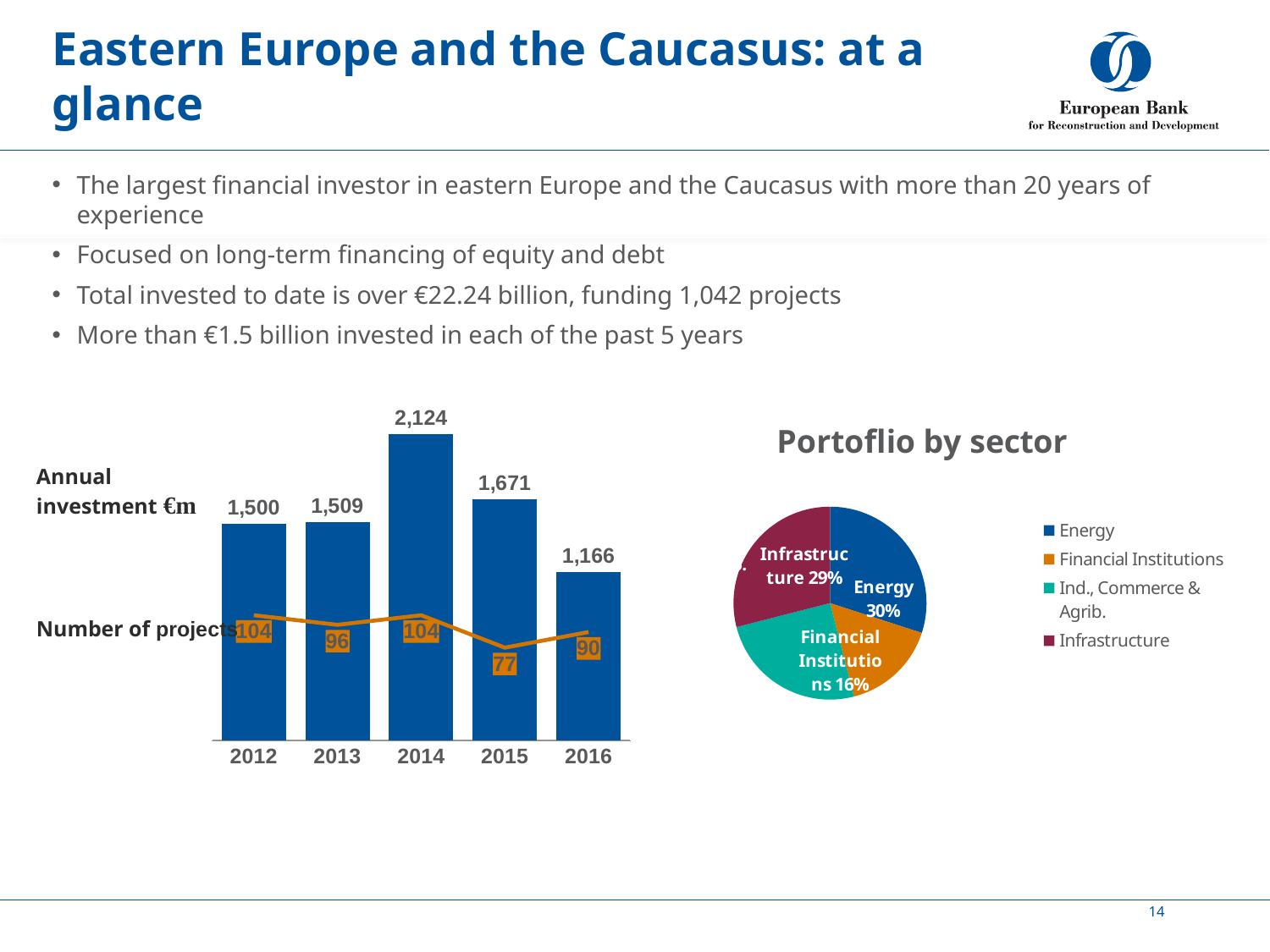
In the annual investment chart on the left, what was the annual investment in 2014? 2,124 In the annual investment chart on the left, which year had the lowest annual investment? 2016 In the 'Portoflio by sector' pie chart, how many sectors does the legend list? 4 In the annual investment chart on the left, which year had the highest annual investment? 2014 In the annual investment chart on the left, how many years are shown on the x axis? 5 In the annual investment chart on the left, which year had the fewest projects? 2015 What kind of chart is the 'Portoflio by sector' chart? pie chart In the annual investment chart on the left, what is the difference between the annual investment in 2014 and in 2015? 453 In the annual investment chart on the left, how many projects were there in 2015? 77 In the 'Portoflio by sector' pie chart, what share do Financial Institutions have? 16% In the 'Portoflio by sector' pie chart, what share does Energy have? 30% In the annual investment chart on the left, did the annual investment rise or fall from 2014 to 2016? fall